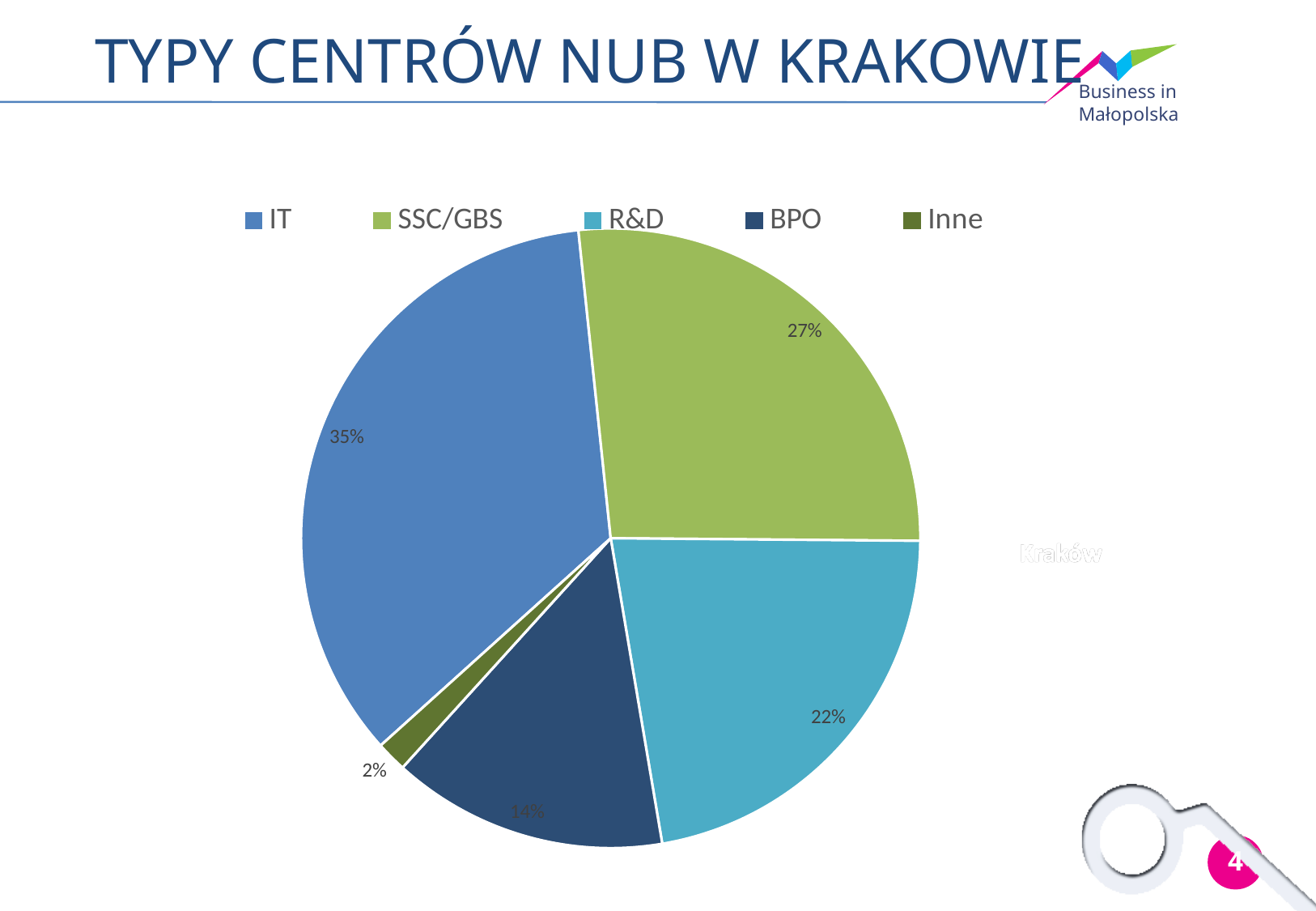
What is the title of the slide? TYPY CENTRÓW NUB W KRAKOWIE What kind of chart is shown on the slide? Pie chart What share of the pie does IT have? 35% What share of the pie does Inne have? 2% Which category has the largest slice of the pie? IT What share of the pie does BPO have? 14% Which category has the smallest slice of the pie? Inne Which is larger, the share for SSC/GBS or the share for R&D? SSC/GBS What is the difference in percentage points between IT and BPO? 21 What share of the pie does R&D have? 22% What share of the pie does SSC/GBS have? 27% How many categories does the pie chart show? 5